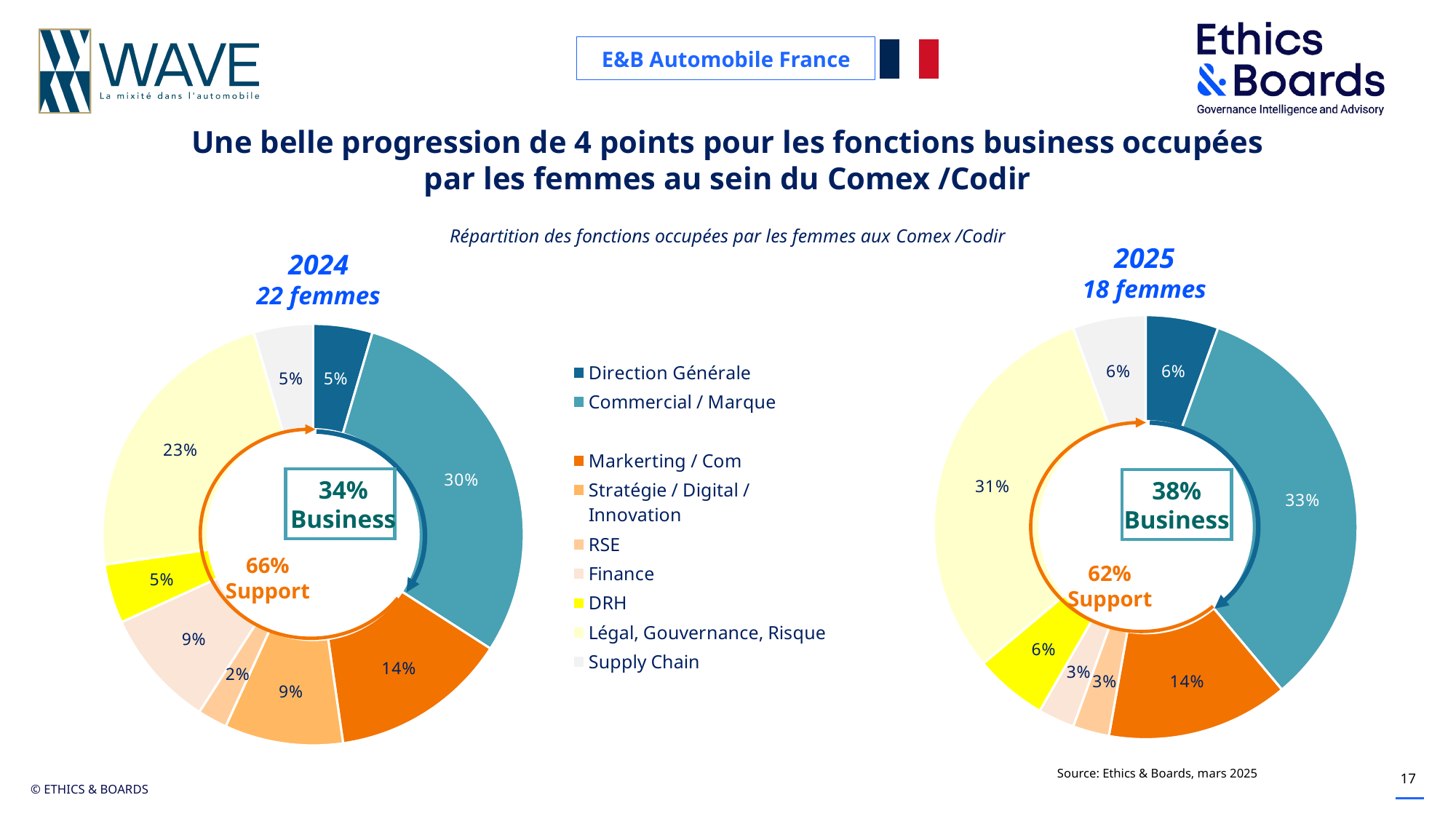
In the 2024 chart, what share is Commercial / Marque? 30% What kind of chart is used on this slide? Donut (pie) chart In the 2024 chart, what share is Markerting / Com? 14% How many functions does the legend list? 9 In the 2024 chart, which function has the smallest share? RSE In the 2025 chart, what share is Commercial / Marque? 33% What percentage of functions is labelled Support in the 2024 chart? 66% What percentage of functions is labelled Business in the 2025 chart? 38% In the 2024 chart, which function has the largest share? Commercial / Marque What is the difference between the Commercial / Marque share in 2025 and in 2024? 3 points In the 2025 chart, what share is Légal, Gouvernance, Risque? 31% In the 2024 chart, what share is Légal, Gouvernance, Risque? 23%